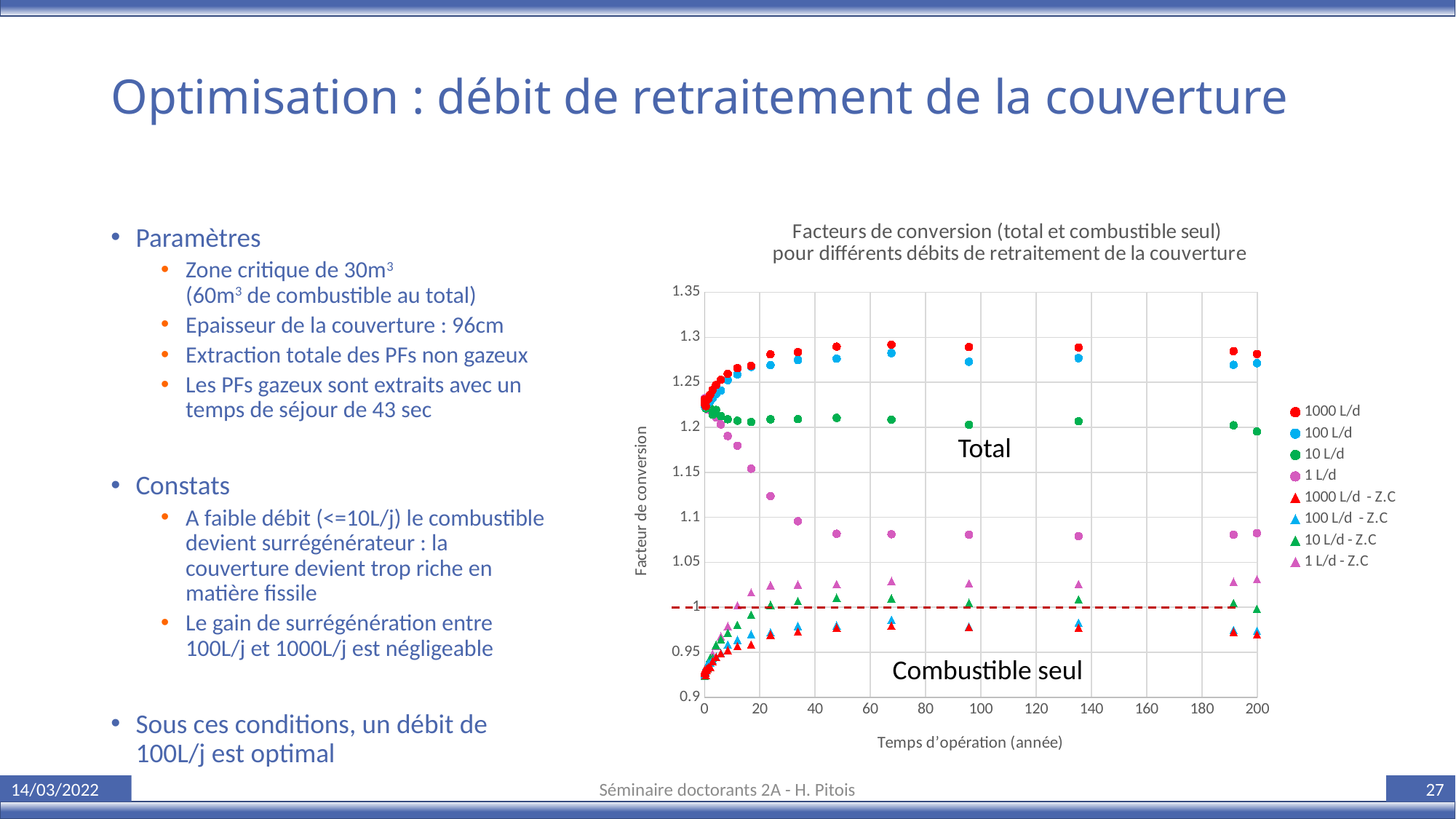
Is the value for the 1000 L/d series at 200 years greater or less than 1.25? greater Is the value for the 1 L/d series at 200 years greater or less than 1.15? less Is the value for the 1000 L/d - Z.C series at 200 years greater or less than 1? less Which series has the highest value at 200 years? 1000 L/d At 200 years, which series has the larger value: 1 L/d - Z.C or 1000 L/d - Z.C? 1 L/d - Z.C What is the title of the chart? Facteurs de conversion (total et combustible seul) pour différents débits de retraitement de la couverture How many series does the chart legend list? 8 At 200 years, which series has the larger value: 1000 L/d or 1 L/d? 1000 L/d What kind of chart is shown on the slide? scatter chart What is the label of the x axis of the chart? Temps d'opération (année) Does the 1000 L/d - Z.C series rise or fall as the operating time increases from 0 to 200 years? rise